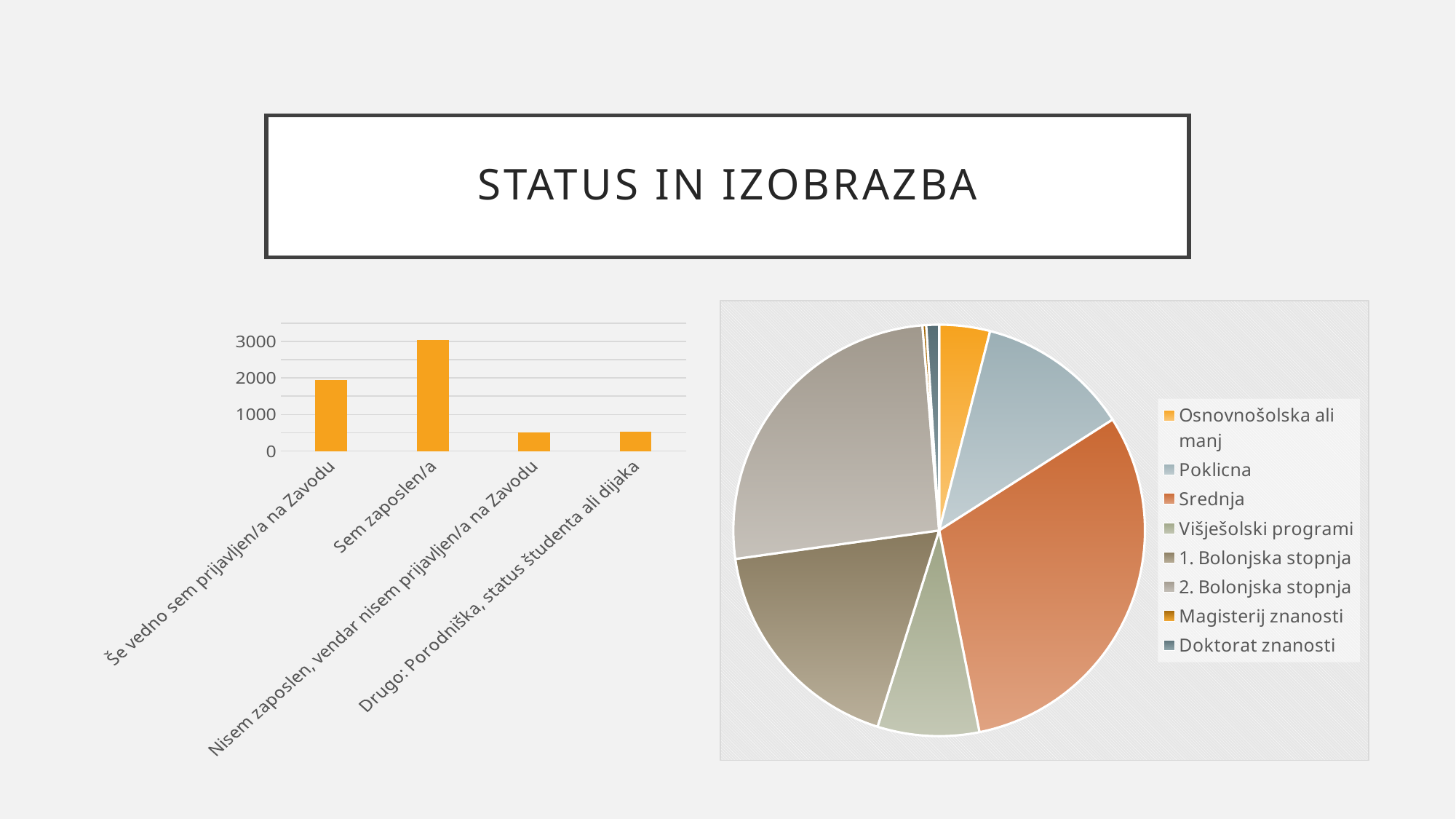
In the bar chart on the left, is the value for Drugo: Porodniška, status študenta ali dijaka greater or less than 1000? less In the bar chart on the left, which category has the highest value? Sem zaposlen/a In the bar chart on the left, which is larger: the value for Sem zaposlen/a or the value for Še vedno sem prijavljen/a na Zavodu? Sem zaposlen/a In the pie chart on the right, which legend entry is listed first? Osnovnošolska ali manj In the pie chart on the right, how many entries does the legend list? 8 In the bar chart on the left, is the value for Še vedno sem prijavljen/a na Zavodu greater or less than 1000? greater What kind of chart is the chart on the right of the slide? pie chart In the bar chart on the left, is the value for Sem zaposlen/a greater or less than 2000? greater What kind of chart is the chart on the left of the slide? bar chart In the pie chart on the right, which category has the largest slice? Srednja In the bar chart on the left, how many categories are shown? 4